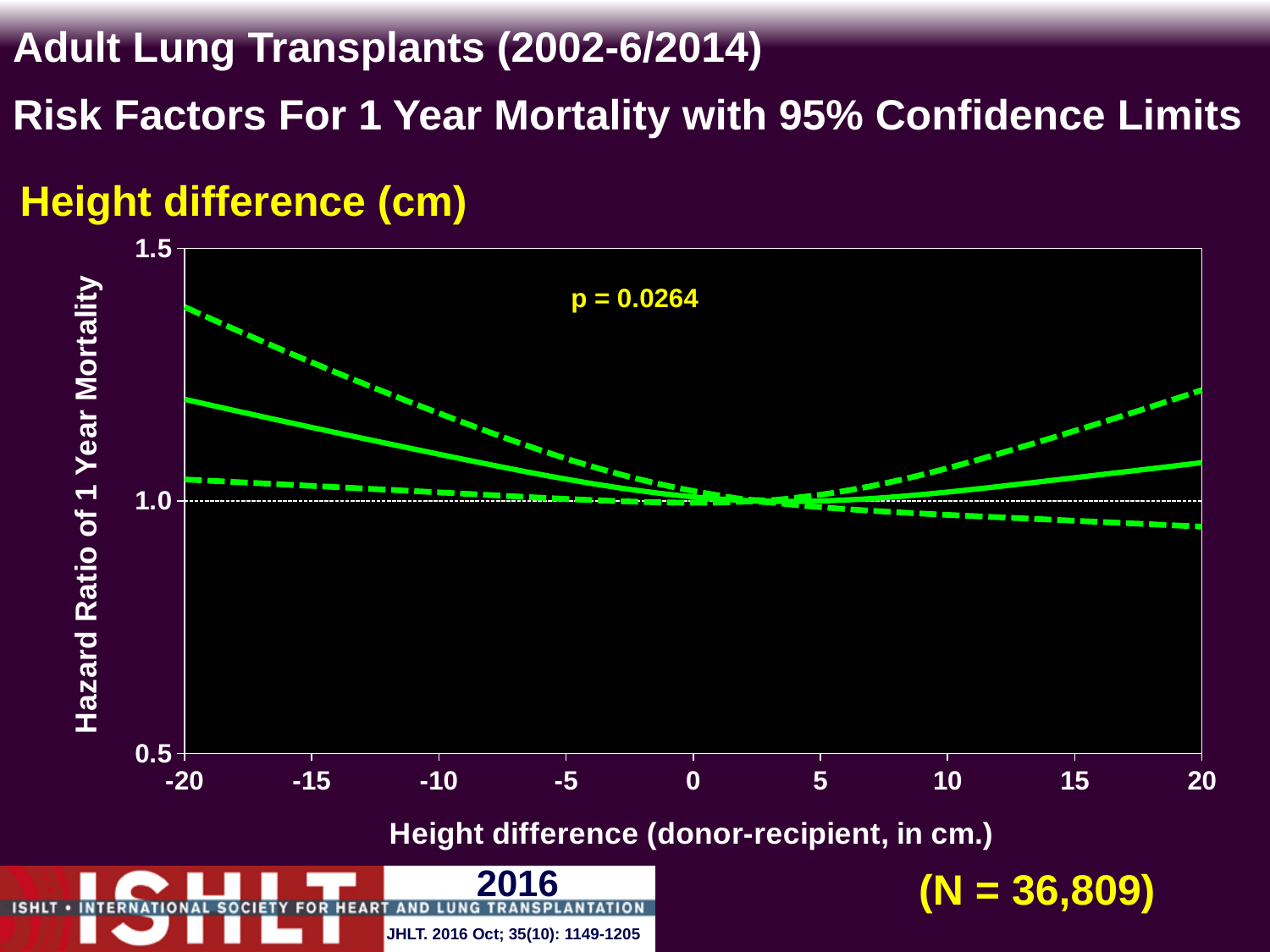
Is the upper confidence limit at a height difference of -20 cm greater or less than 1.0? greater What is the p-value printed on the chart? p = 0.0264 Does the hazard ratio (solid line) rise or fall as the height difference increases from 5 cm to 20 cm? rise What is the label of the y axis? Hazard Ratio of 1 Year Mortality What sample size (N) is printed on the slide? N = 36,809 Is the lower confidence limit at a height difference of 20 cm greater or less than 1.0? less What is the label of the x axis? Height difference (donor-recipient, in cm.) Which is larger: the hazard ratio (solid line) at a height difference of -20 cm or at 20 cm? -20 cm What kind of chart is shown on the slide? line chart Is the hazard ratio (solid line) at a height difference of -20 cm greater or less than 1.0? greater Does the hazard ratio (solid line) rise or fall as the height difference increases from -20 cm to 0 cm? fall